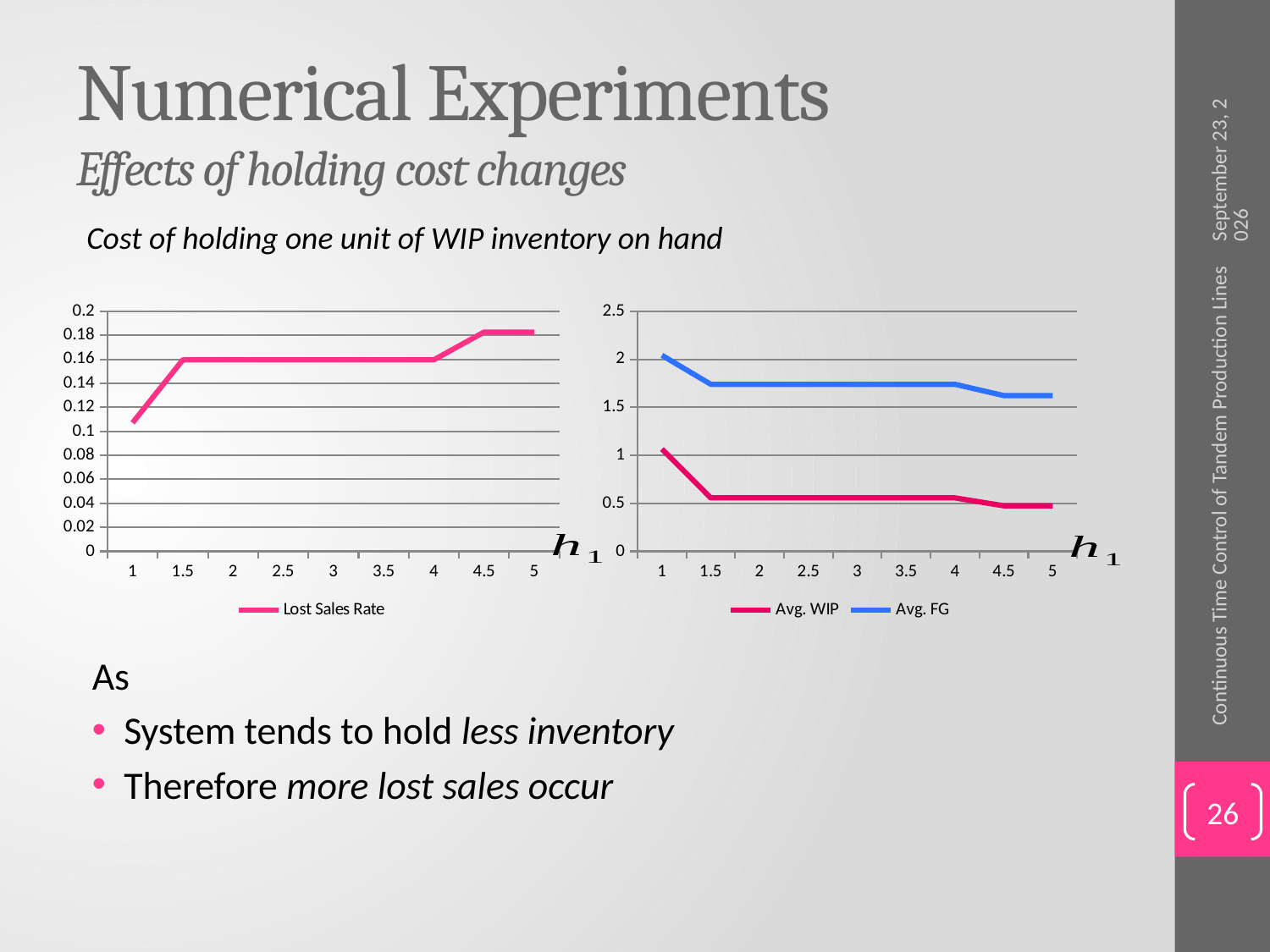
In the left chart, is the Lost Sales Rate at h1 = 1 greater or less than 0.12? less How many series does the legend of the right chart list? 2 In the right chart, at h1 = 2, which series has the larger value, Avg. WIP or Avg. FG? Avg. FG What are the two series named in the legend of the right chart? Avg. WIP and Avg. FG In the left chart, at which h1 value is the Lost Sales Rate lowest? 1 In the right chart, is Avg. FG at h1 = 3 greater or less than 2? less In the left chart, is the Lost Sales Rate at h1 = 5 greater or less than 0.16? greater In the left chart, does the Lost Sales Rate generally rise or fall as h1 increases? rise What kind of chart is the left chart (Lost Sales Rate)? line chart In the right chart, at which h1 value is Avg. WIP highest? 1 In the right chart, does Avg. FG generally rise or fall as h1 increases? fall How many h1 values are plotted along the x axis of the left chart? 9